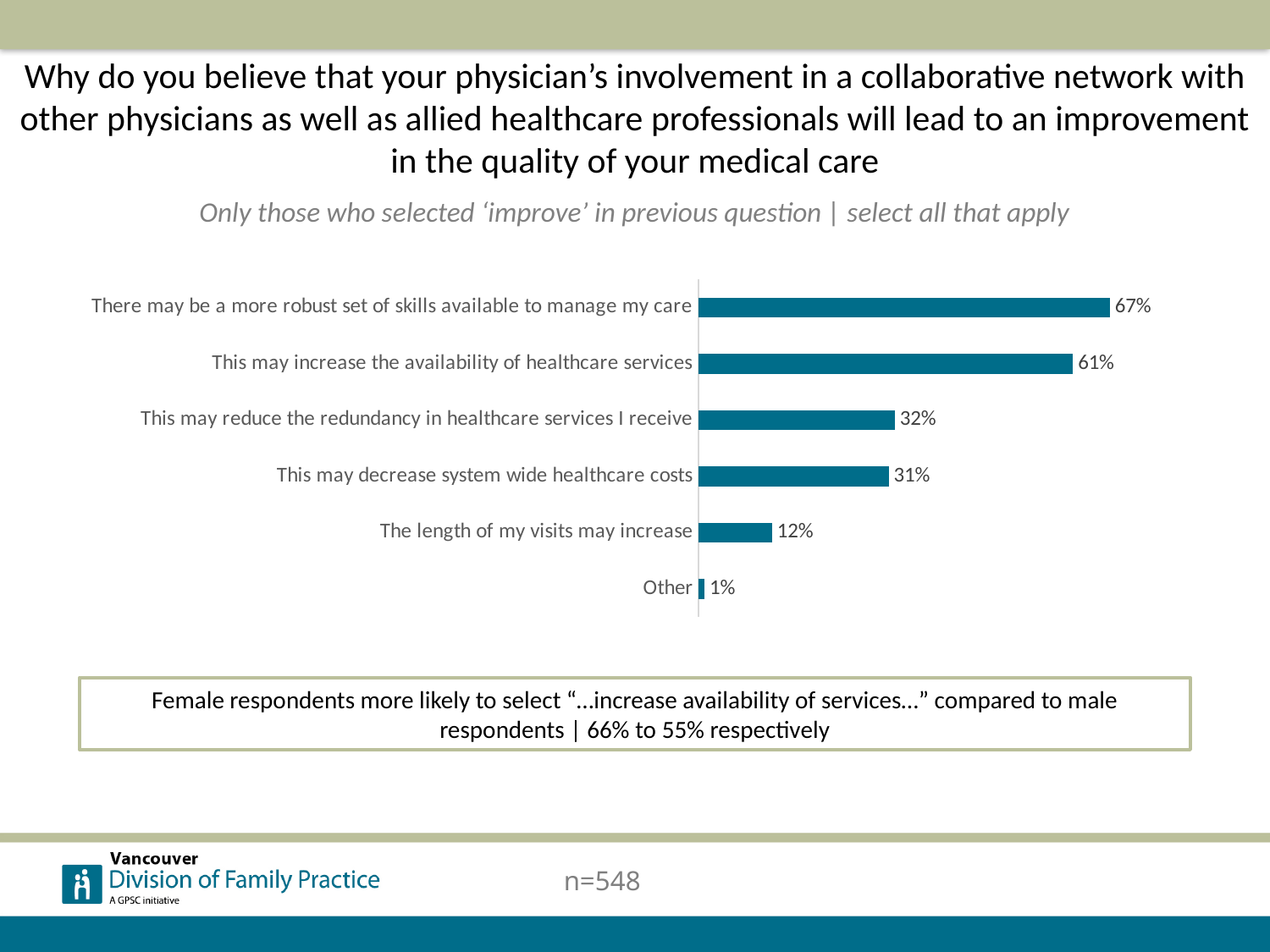
How many categories are shown in the chart? 6 What percentage selected "The length of my visits may increase"? 12% Which is larger: "This may increase the availability of healthcare services" or "This may decrease system wide healthcare costs"? This may increase the availability of healthcare services Which category has the lowest percentage? Other What is the difference between "This may reduce the redundancy in healthcare services I receive" and "This may decrease system wide healthcare costs"? 1% Which reason has the highest percentage? There may be a more robust set of skills available to manage my care What type of chart is shown on the slide? Bar chart What is the sample size (n) shown on the slide? n=548 What is the difference in percentage points between the top two reasons? 6% What is the value for "This may increase the availability of healthcare services"? 61% What is the value shown for "Other"? 1% What percentage of respondents selected "There may be a more robust set of skills available to manage my care"? 67%